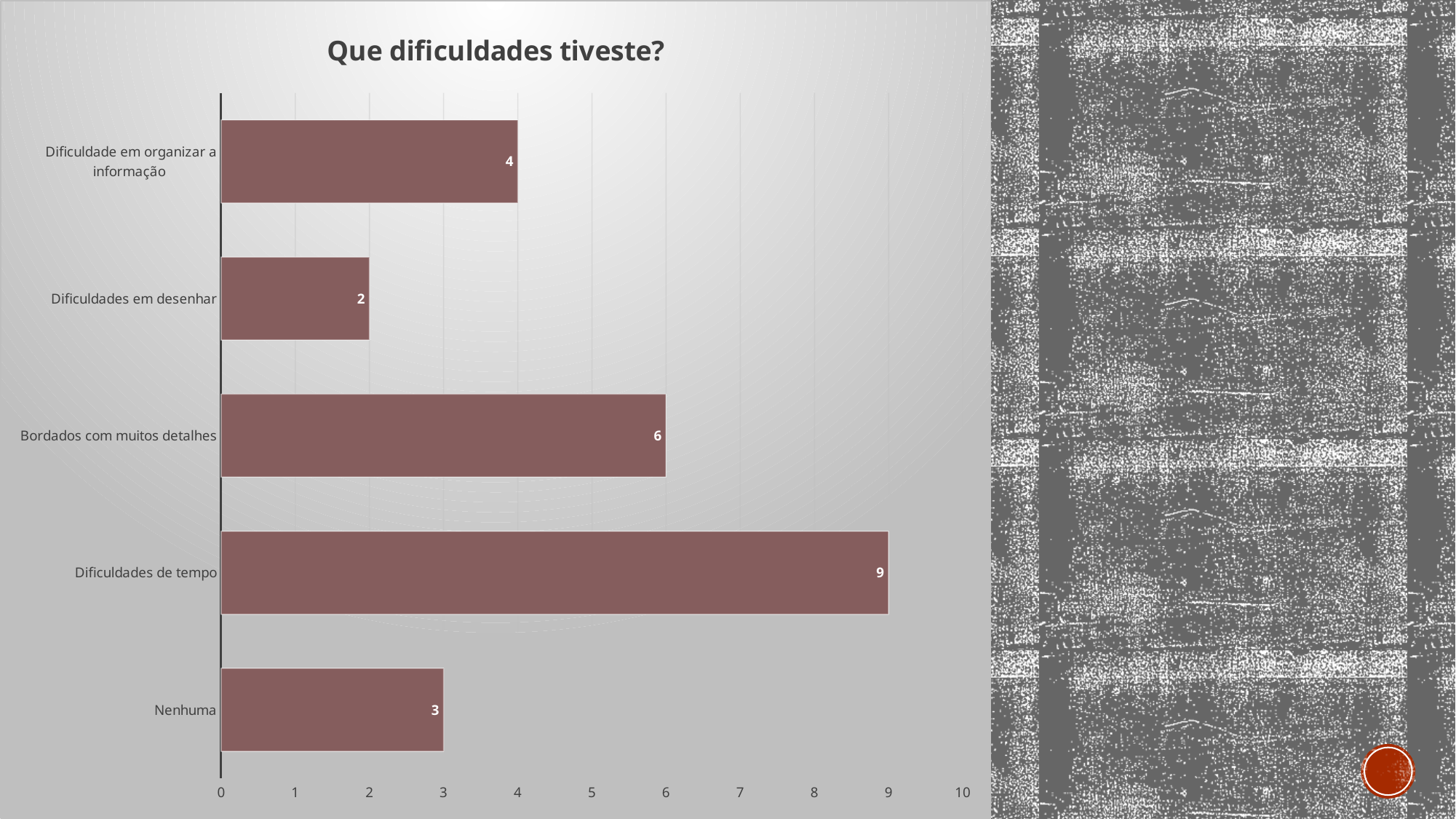
How many categories are shown in the chart? 5 Which category has the highest value? Dificuldades de tempo Is the value for "Bordados com muitos detalhes" greater or less than 5? greater What is the difference between the values for "Dificuldades de tempo" and "Bordados com muitos detalhes"? 3 What is the value for "Dificuldades de tempo"? 9 What is the title of the chart? Que dificuldades tiveste? What is the value for "Dificuldades em desenhar"? 2 What is the value for "Nenhuma"? 3 What kind of chart is shown on the slide? bar chart Which category has the lowest value? Dificuldades em desenhar What is the value for "Bordados com muitos detalhes"? 6 Which is larger, the value for "Dificuldade em organizar a informação" or the value for "Nenhuma"? Dificuldade em organizar a informação